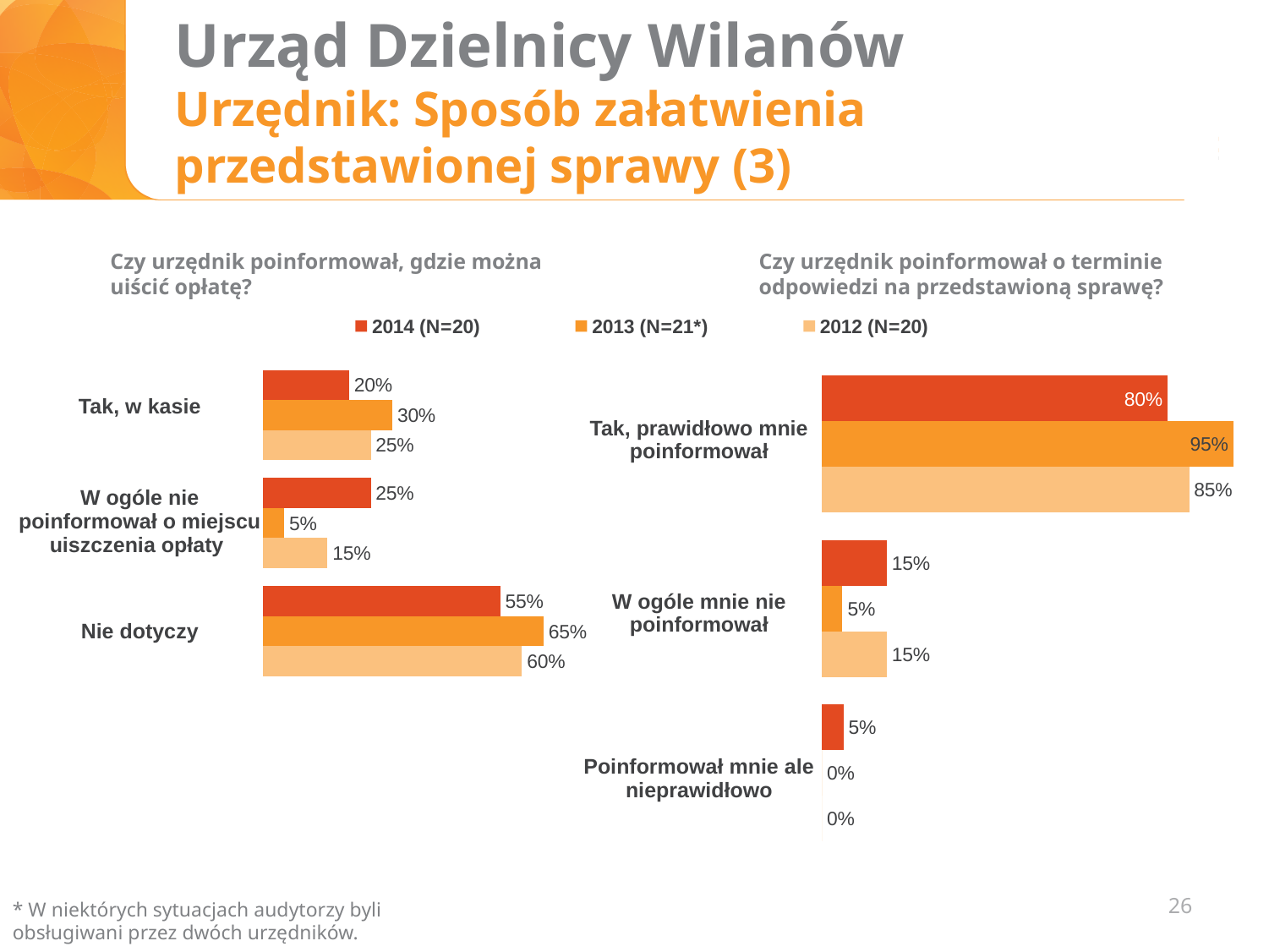
How many series does the legend list? 3 How many categories does the right chart (Czy urzędnik poinformował o terminie odpowiedzi na przedstawioną sprawę?) show? 3 In the left chart (Czy urzędnik poinformował, gdzie można uiścić opłatę?), which is larger: the 2014 value for 'Tak, w kasie' or the 2014 value for 'W ogóle nie poinformował o miejscu uiszczenia opłaty'? W ogóle nie poinformował o miejscu uiszczenia opłaty What kind of chart is the left chart (Czy urzędnik poinformował, gdzie można uiścić opłatę?)? Bar chart In the left chart (Czy urzędnik poinformował, gdzie można uiścić opłatę?), what is the value for 'Tak, w kasie' in 2013? 30% In the right chart (Czy urzędnik poinformował o terminie odpowiedzi na przedstawioną sprawę?), what is the value for 'Tak, prawidłowo mnie poinformował' in 2012? 85% In the left chart (Czy urzędnik poinformował, gdzie można uiścić opłatę?), what is the value for 'Nie dotyczy' in 2014? 55% In the right chart (Czy urzędnik poinformował o terminie odpowiedzi na przedstawioną sprawę?), which year has the highest value for 'Tak, prawidłowo mnie poinformował'? 2013 In the right chart (Czy urzędnik poinformował o terminie odpowiedzi na przedstawioną sprawę?), what is the value for 'Poinformował mnie ale nieprawidłowo' in 2014? 5% In the left chart (Czy urzędnik poinformował, gdzie można uiścić opłatę?), which year has the lowest value for 'W ogóle nie poinformował o miejscu uiszczenia opłaty'? 2013 In the right chart (Czy urzędnik poinformował o terminie odpowiedzi na przedstawioną sprawę?), what is the difference between the 2013 and 2014 values for 'Tak, prawidłowo mnie poinformował'? 15% In the left chart (Czy urzędnik poinformował, gdzie można uiścić opłatę?), what is the difference between the 2013 and 2014 values for 'Nie dotyczy'? 10%